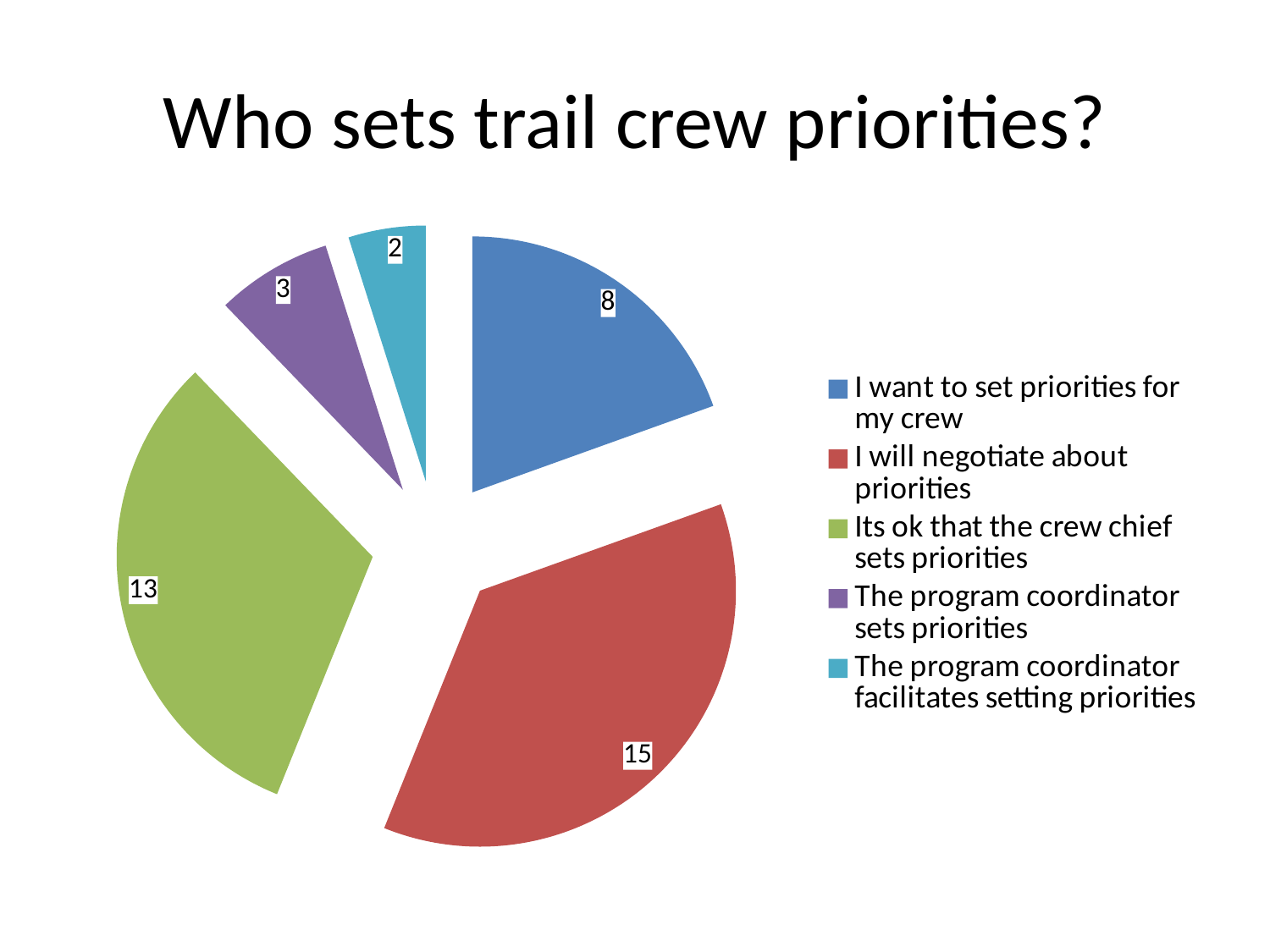
Which category has the largest slice? I will negotiate about priorities What kind of chart is shown on the slide? pie chart What is the value for "I will negotiate about priorities"? 15 What is the title of the chart? Who sets trail crew priorities? Which is larger: "I want to set priorities for my crew" or "The program coordinator sets priorities"? I want to set priorities for my crew Which category has the smallest slice? The program coordinator facilitates setting priorities What is the value for "The program coordinator facilitates setting priorities"? 2 How many categories does the pie chart have? 5 What is the total of all the slices in the pie chart? 41 What is the value for "I want to set priorities for my crew"? 8 What colour is the slice for "Its ok that the crew chief sets priorities"? green What is the difference between the values for "I will negotiate about priorities" and "Its ok that the crew chief sets priorities"? 2